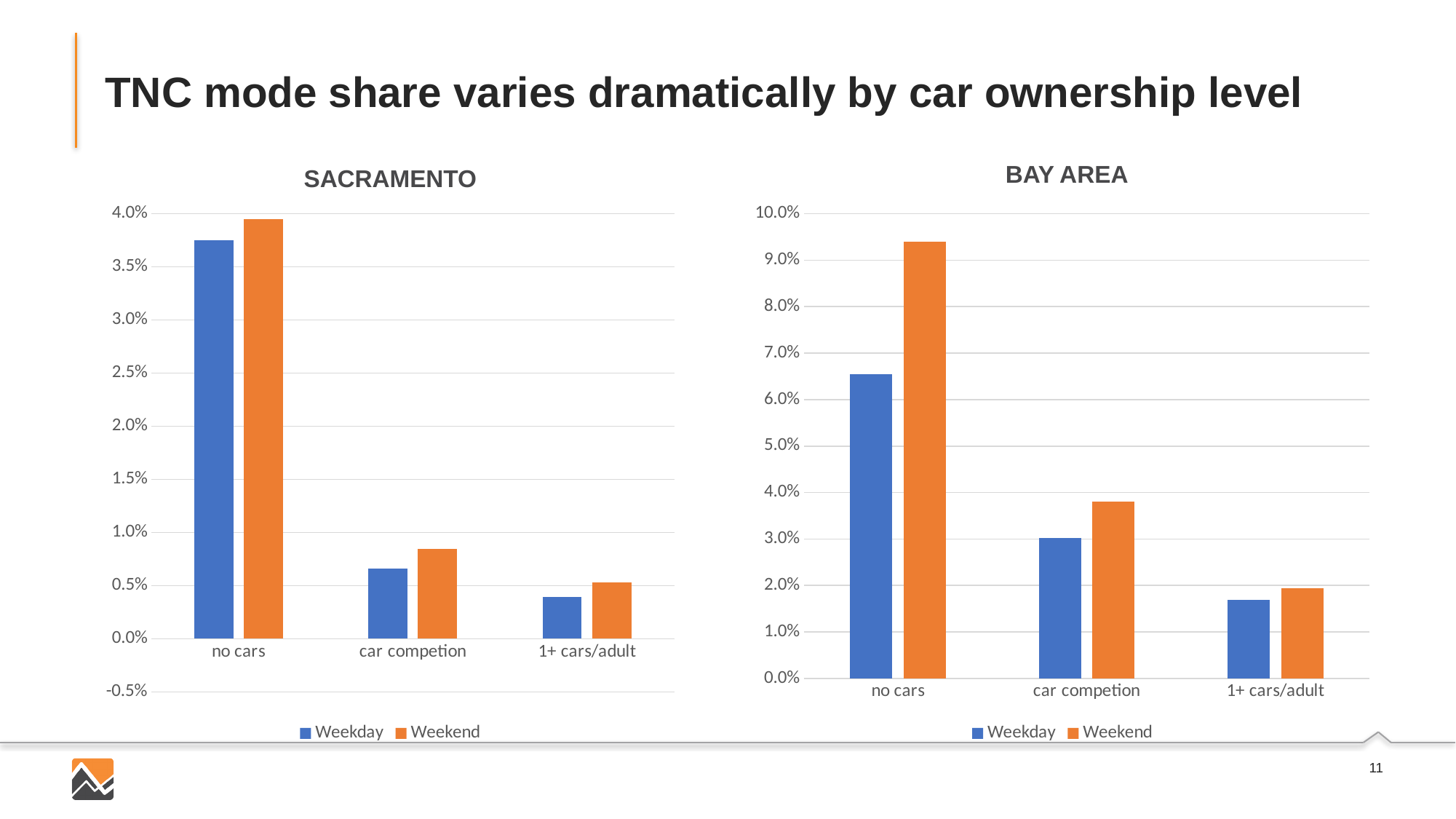
What kind of chart is the BAY AREA chart? bar chart In the BAY AREA chart, do the Weekday values rise or fall from no cars to 1+ cars/adult? fall How many categories are shown on the x axis of the BAY AREA chart? 3 In the BAY AREA chart, is the Weekend value for no cars greater or less than 9.0%? greater In the BAY AREA chart, which is larger for no cars: the Weekday value or the Weekend value? Weekend In the SACRAMENTO chart, is the Weekday value for no cars greater or less than 3.5%? greater In the BAY AREA chart, which category has the lowest Weekday value? 1+ cars/adult In the SACRAMENTO chart, which category has the highest Weekend value? no cars How many series does the legend of the SACRAMENTO chart list? 2 In the BAY AREA chart, is the Weekend value for car competion greater or less than 4.0%? less In the SACRAMENTO chart, which is larger for 1+ cars/adult: the Weekday value or the Weekend value? Weekend